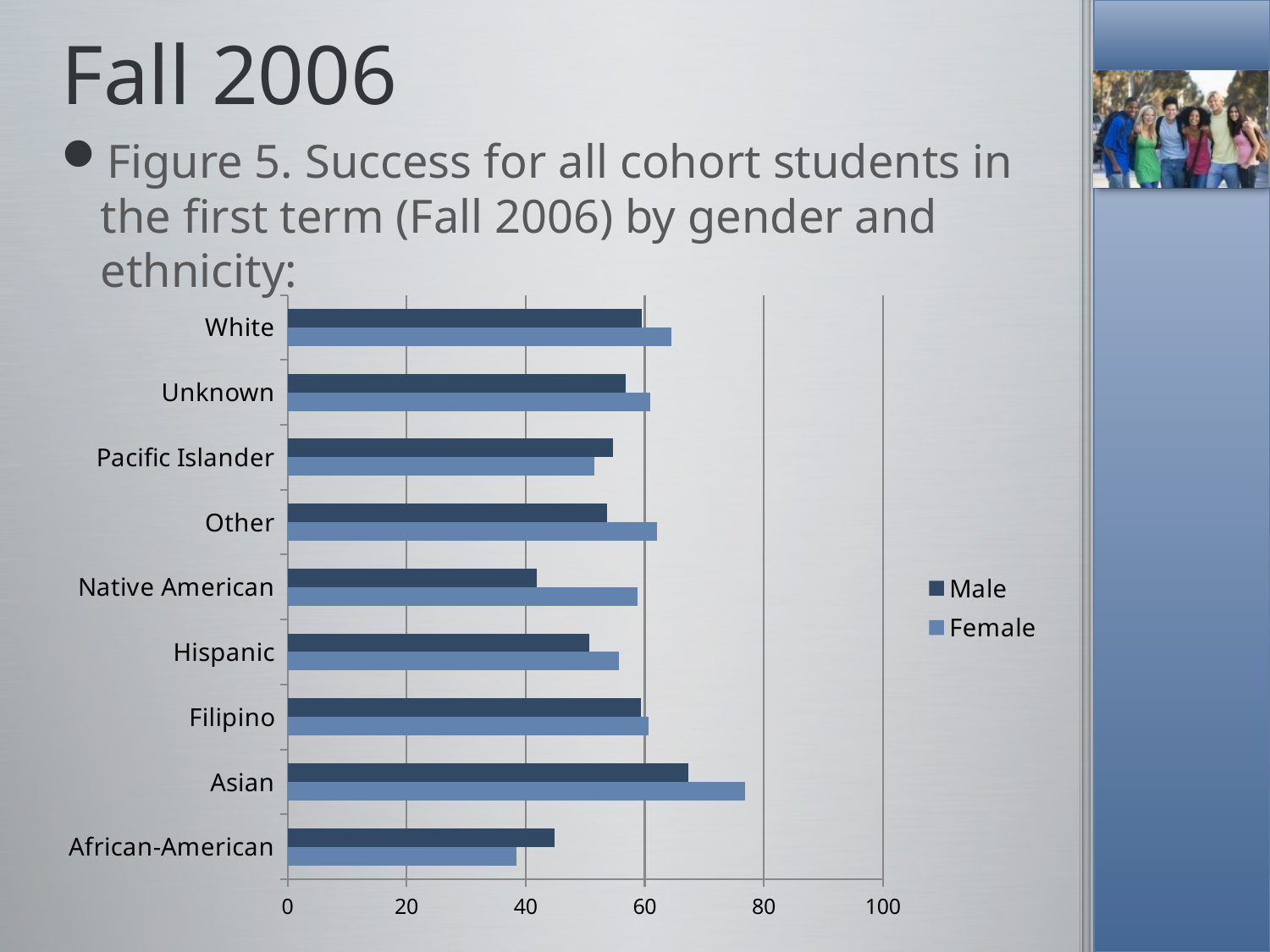
Is the Male value for Asian greater or less than 60? greater Which series are listed in the legend? Male and Female How many series does the legend list? 2 What kind of chart is shown on the slide? bar chart Which category has the highest Female value? Asian For African-American, which is larger, the Male value or the Female value? Male For Native American, which is larger, the Male value or the Female value? Female Is the Female value for Asian greater or less than 60? greater Which category has the lowest Female value? African-American Is the Male value for Native American greater or less than 60? less Which category has the highest Male value? Asian How many ethnicity categories are shown on the chart? 9